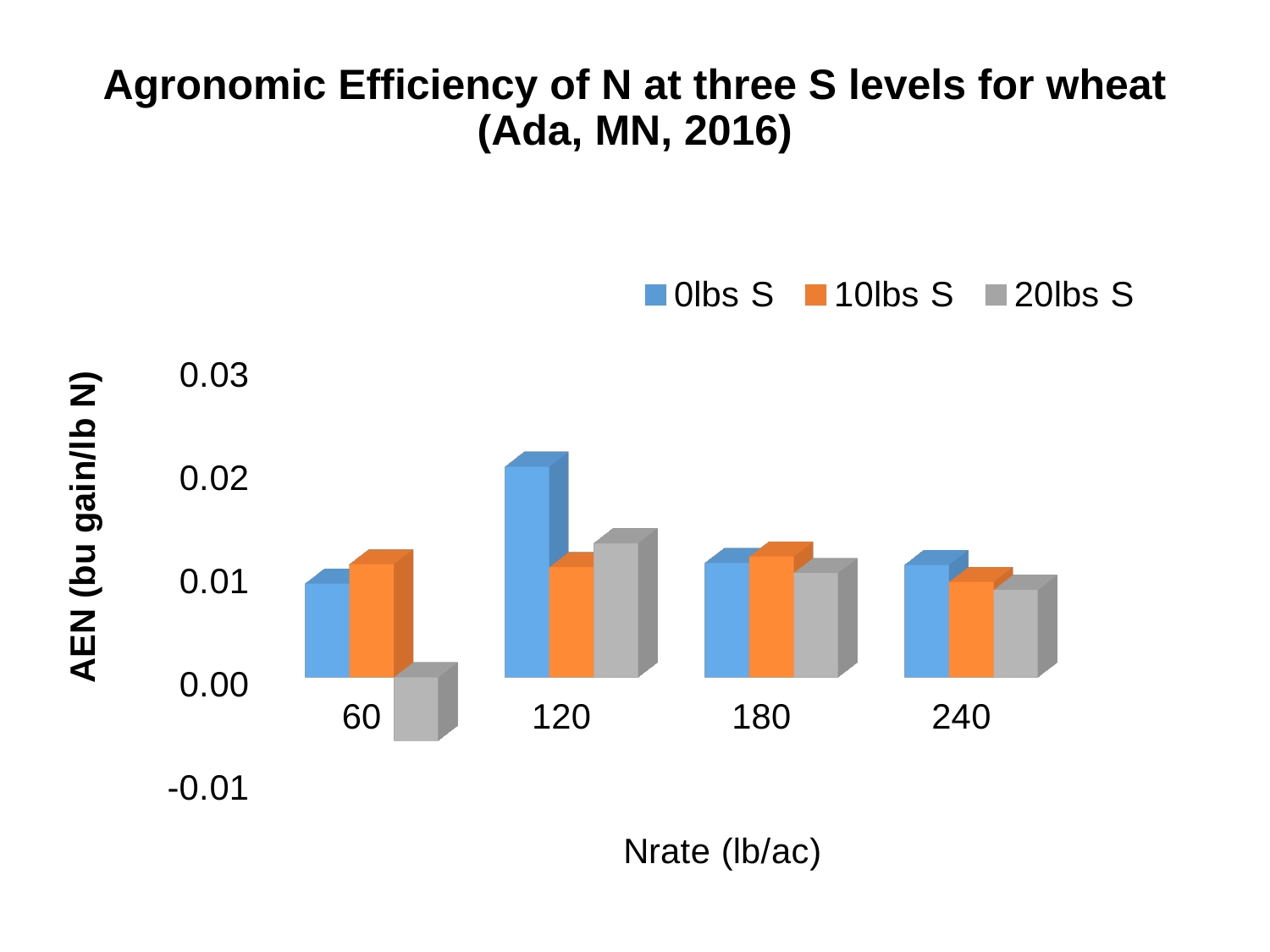
What kind of chart is shown on the slide? bar chart Which N rate has the highest value for 0lbs S? 120 Is the value for 0lbs S at an N rate of 120 greater or less than 0.01? greater What is the label of the x axis? Nrate (lb/ac) Which series has the highest value at an N rate of 120? 0lbs S Is the value for 20lbs S at an N rate of 60 greater or less than 0.00? less At an N rate of 60, which is larger: 10lbs S or 20lbs S? 10lbs S What is the label of the y axis? AEN (bu gain/lb N) How many series does the legend list? 3 How many N rate categories are shown on the x axis? 4 Which series has the lowest value at an N rate of 60? 20lbs S